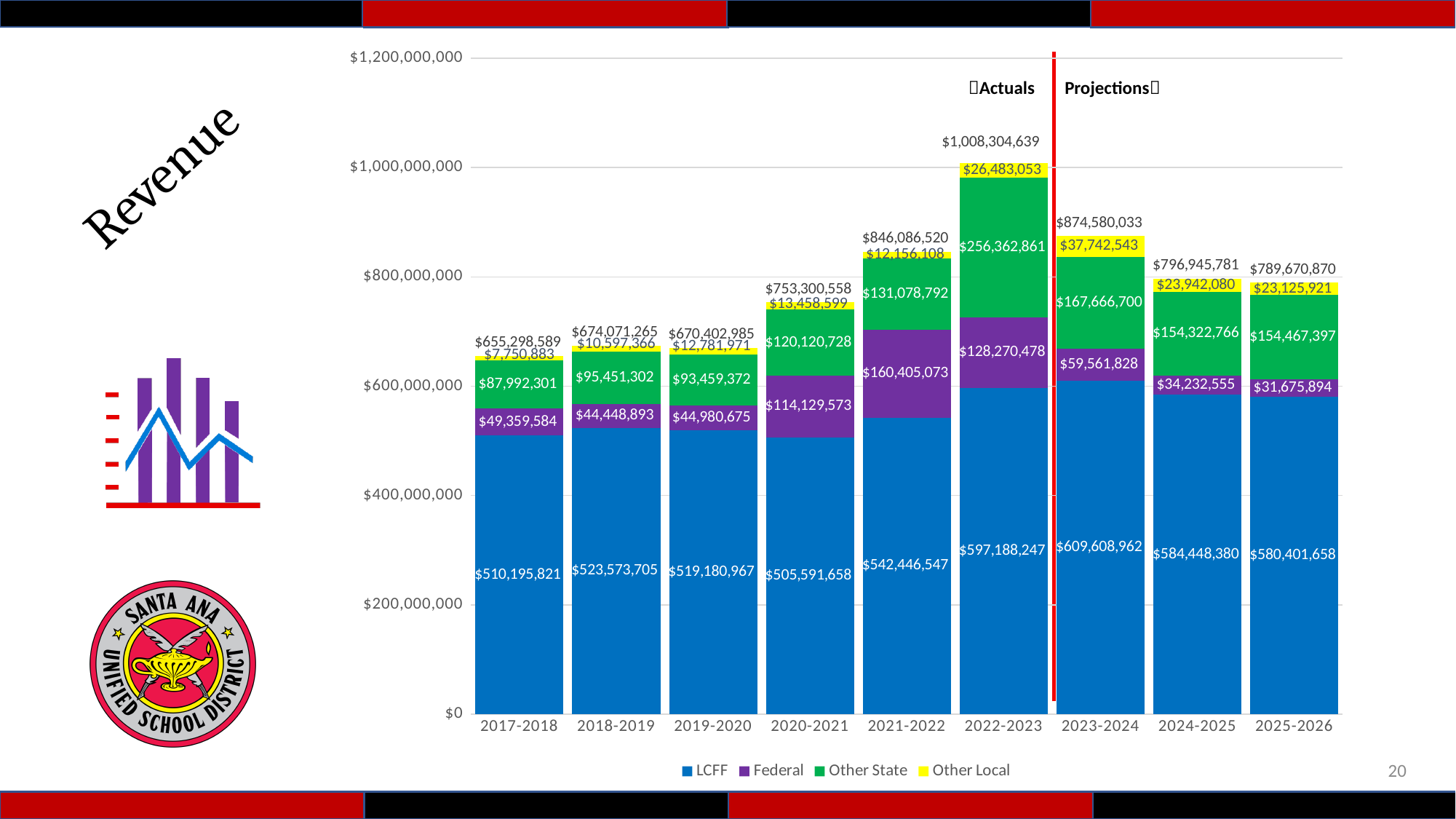
How many years are shown on the x axis? 9 Which year has the larger Federal value, 2021-2022 or 2022-2023? 2021-2022 What is the LCFF value for 2022-2023? $597,188,247 How much larger is the LCFF value for 2023-2024 than for 2022-2023? $12,420,715 Which year has the highest total revenue? 2022-2023 What is the Other State value for 2023-2024? $167,666,700 What is the Federal value for 2021-2022? $160,405,073 What is the Other Local value for 2017-2018? $7,750,883 Which year has the lowest total revenue? 2017-2018 How many series does the legend list? 4 What is the total revenue shown for the 2022-2023 bar? $1,008,304,639 Is the total revenue for 2021-2022 greater or less than $800,000,000? greater